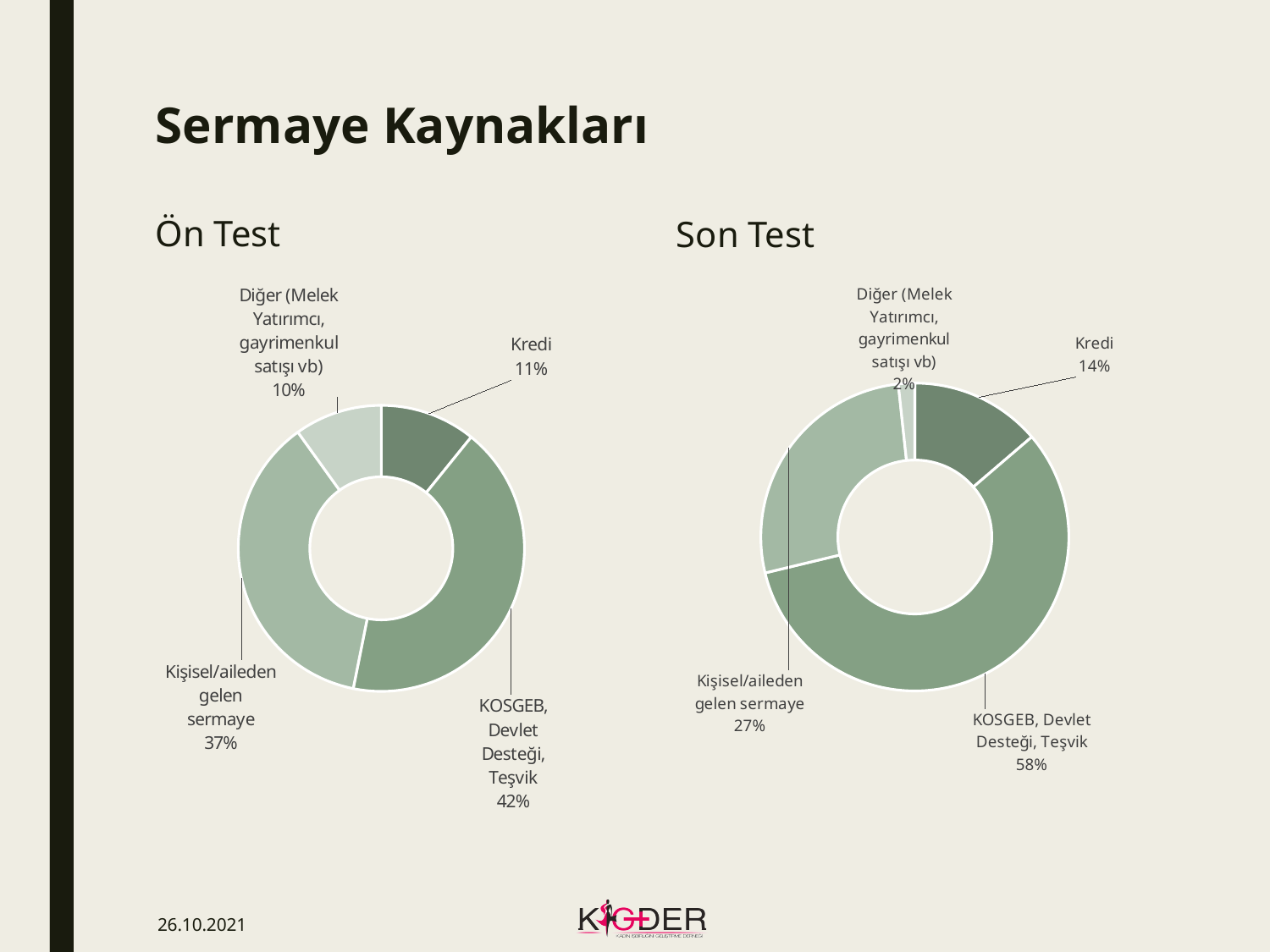
In the Ön Test chart, what share does KOSGEB, Devlet Desteği, Teşvik have? 42% What type of chart is used for Ön Test and Son Test? Doughnut (pie) chart What is the difference between the KOSGEB, Devlet Desteği, Teşvik share in the Son Test chart and in the Ön Test chart? 16 percentage points How many categories does the Ön Test chart show? 4 Is the Kredi share larger in the Ön Test chart or the Son Test chart? Son Test In the Ön Test chart, which category has the smallest share? Diğer (Melek Yatırımcı, gayrimenkul satışı vb) In the Son Test chart, what share does Diğer (Melek Yatırımcı, gayrimenkul satışı vb) have? 2% In the Son Test chart, which category has the smallest share? Diğer (Melek Yatırımcı, gayrimenkul satışı vb) In the Ön Test chart, what is the difference between the KOSGEB, Devlet Desteği, Teşvik share and the Kişisel/aileden gelen sermaye share? 5 percentage points In the Ön Test chart, what share does Kredi have? 11% In the Son Test chart, what share does Kişisel/aileden gelen sermaye have? 27% In the Son Test chart, which category has the largest share? KOSGEB, Devlet Desteği, Teşvik